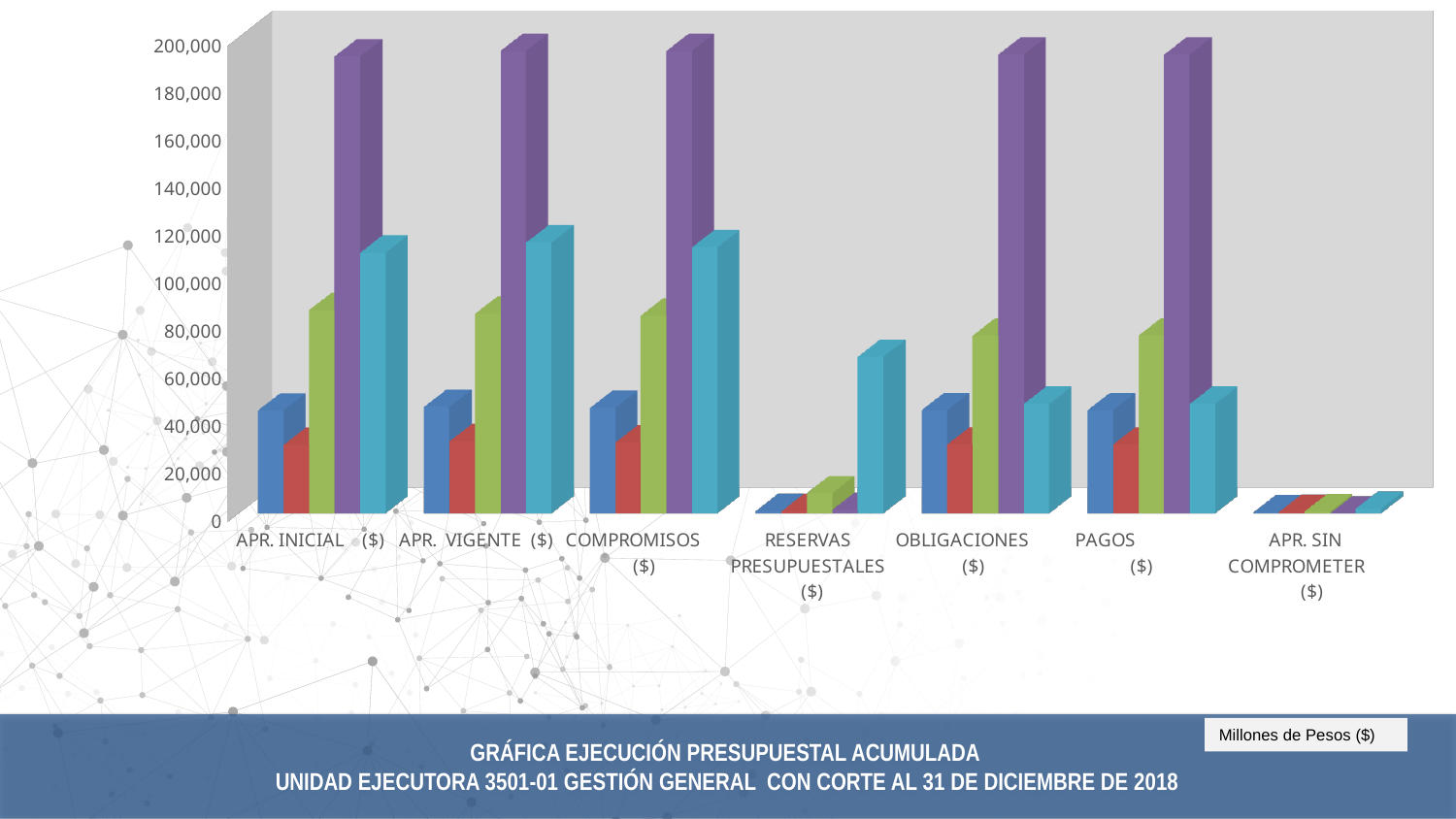
Which is larger: the green bar for APR. INICIAL ($) or the green bar for RESERVAS PRESUPUESTALES ($)? APR. INICIAL ($) Is the value of the light blue bar for RESERVAS PRESUPUESTALES ($) greater or less than 100,000? less How many bars are plotted for each category in the chart? 5 What kind of chart is shown on the slide? bar chart Is the value of the green bar for RESERVAS PRESUPUESTALES ($) greater or less than 20,000? less Which category has the lowest values across all of its bars? APR. SIN COMPROMETER ($) Is the value of the dark blue bar for PAGOS ($) greater or less than 60,000? less How many categories are shown along the x axis of the chart? 7 Which is larger: the light blue bar for RESERVAS PRESUPUESTALES ($) or the light blue bar for OBLIGACIONES ($)? RESERVAS PRESUPUESTALES ($) What unit is indicated for the values in the chart? Millones de Pesos ($)